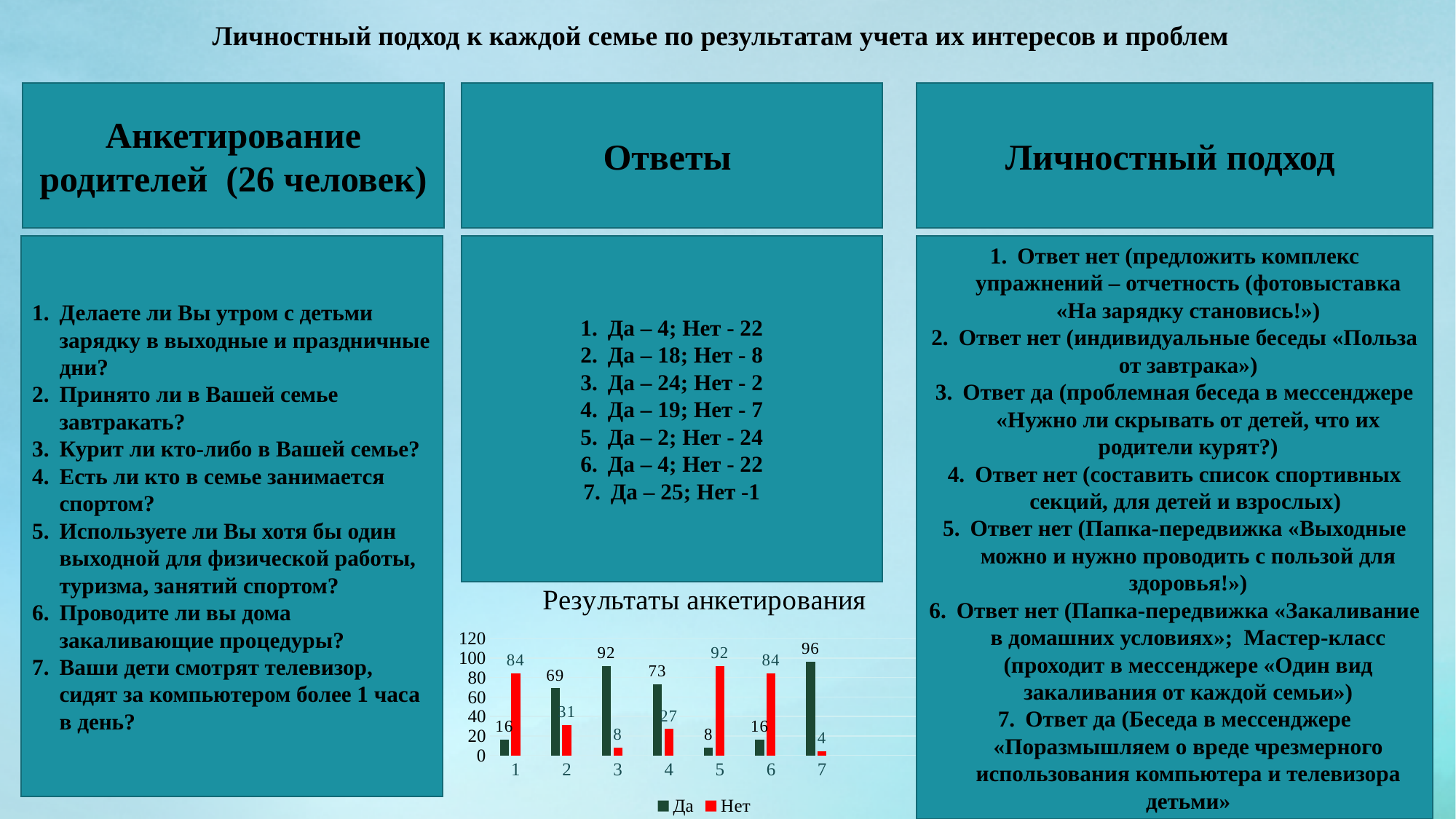
How many categories are shown on the x axis of the chart? 7 What is the difference between the "Да" and "Нет" values for category 2? 38 What is the value of the "Нет" series for category 1? 84 Which colour represents the "Нет" series in the chart? red Which category has the lowest value in the "Нет" series? 7 For category 4, which is larger, the "Да" value or the "Нет" value? Да What type of chart is shown under the heading "Результаты анкетирования"? bar chart How many series does the legend of the chart list? 2 What is the value of the "Да" series for category 3? 92 What is the title of the chart on the slide? Результаты анкетирования What is the value of the "Да" series for category 7? 96 Which category has the highest value in the "Да" series? 7